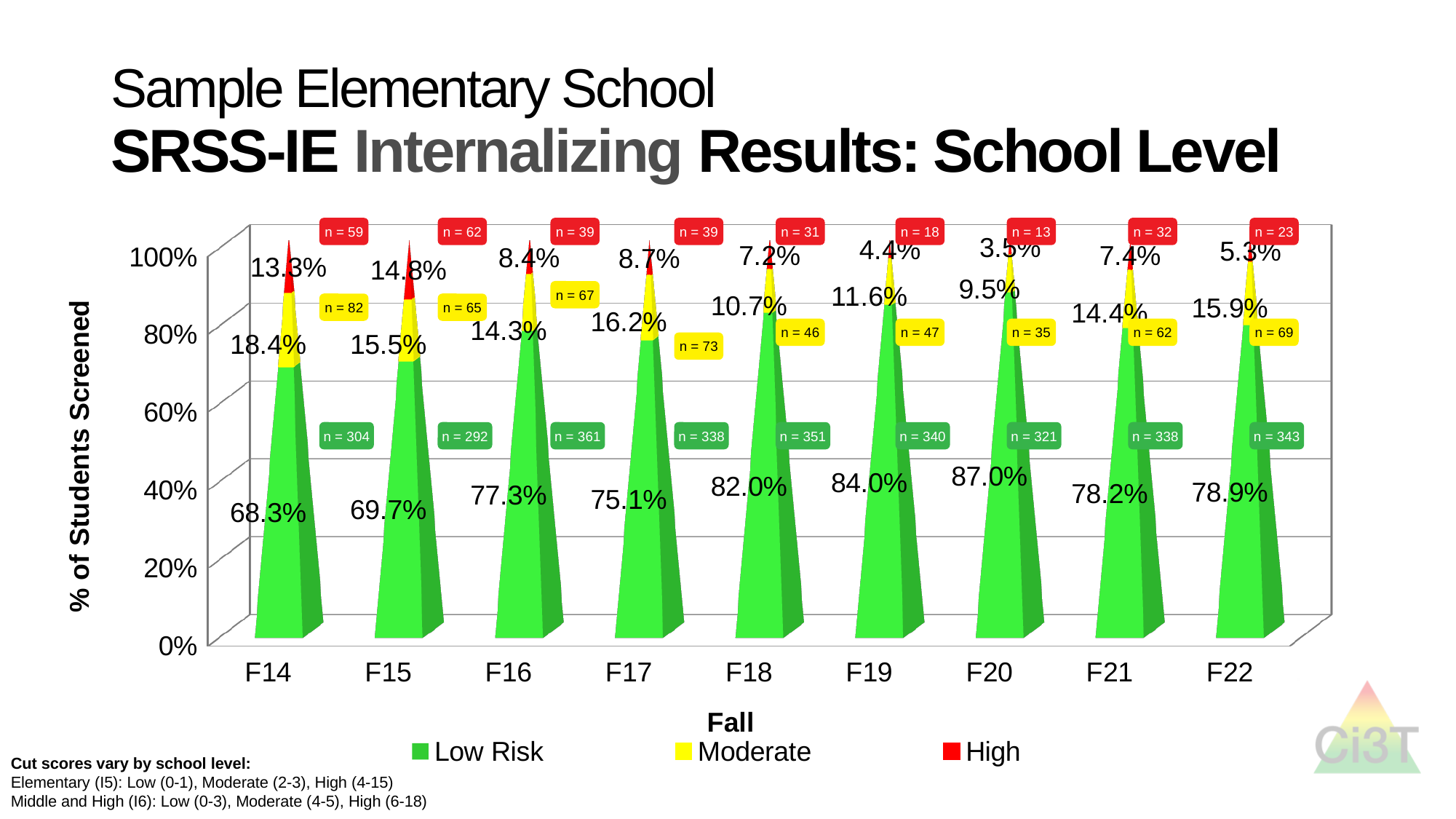
Which fall screening has the highest Low Risk percentage? F20 What is the Moderate percentage for F17? 16.2% How many students were screened as Low Risk in F16 (the n value)? n = 361 What percentage of students were in the High category in F14? 13.3% What is the difference between the Low Risk percentage in F20 and in F14? 18.7% How many series does the legend list? 3 Which fall screening has the lowest Low Risk percentage? F14 What percentage of students were Low Risk in F20? 87.0% Which is larger, the High percentage in F15 or in F22? F15 How many fall screening periods are shown on the x axis? 9 What kind of chart is shown on the slide? Stacked bar chart What is the label on the y axis? % of Students Screened